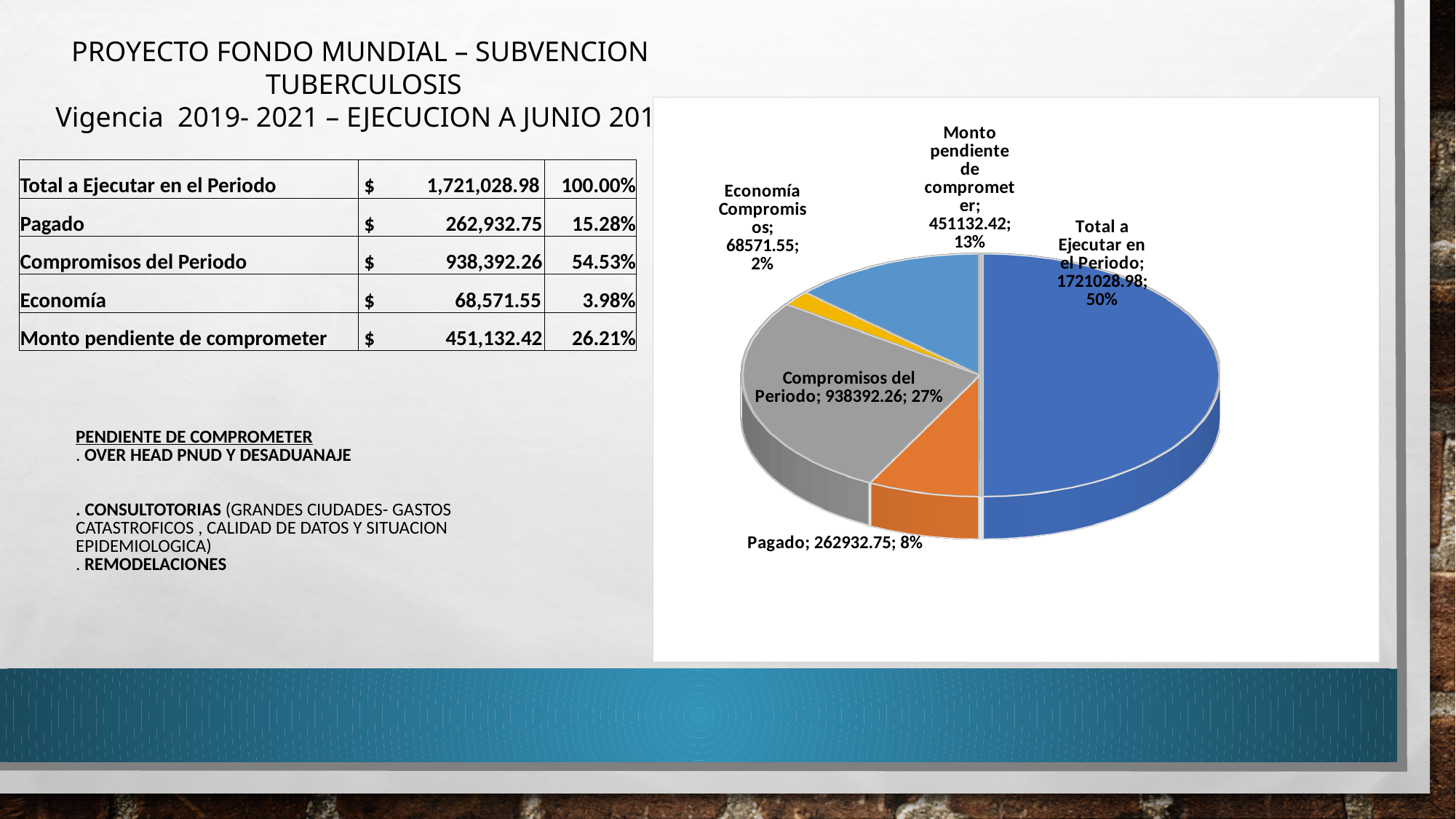
What value is shown for the "Economía Compromisos" slice in the pie chart? 68571.55 Which slice of the pie chart is the smallest? Economía Compromisos What value is shown for the "Pagado" slice in the pie chart? 262932.75 Which is larger in the pie chart, "Pagado" or "Monto pendiente de comprometer"? Monto pendiente de comprometer What colour is the "Pagado" slice in the pie chart? Orange How many slices does the pie chart have? 5 Which slice of the pie chart is the largest? Total a Ejecutar en el Periodo What value is shown for the "Compromisos del Periodo" slice in the pie chart? 938392.26 What percentage share does the "Compromisos del Periodo" slice have in the pie chart? 27% What value is shown for the "Monto pendiente de comprometer" slice in the pie chart? 451132.42 What percentage share does the "Total a Ejecutar en el Periodo" slice have in the pie chart? 50% What type of chart is shown on the slide? Pie chart